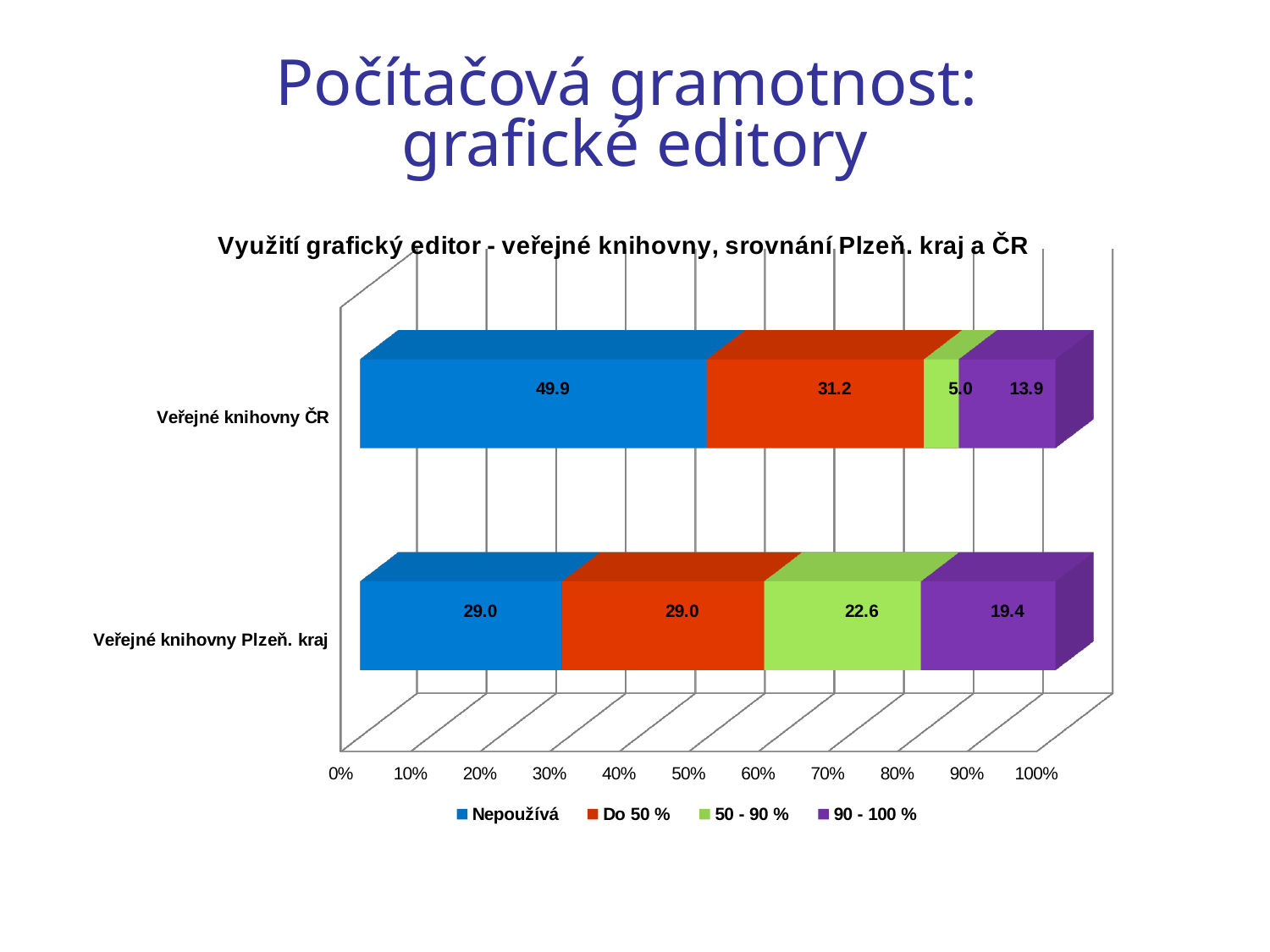
What is the difference between the "90 - 100 %" values for Veřejné knihovny Plzeň. kraj and Veřejné knihovny ČR? 5.5 How many series does the legend list? 4 What is the value of the "50 - 90 %" segment for Veřejné knihovny Plzeň. kraj? 22.6 What is the value of the "90 - 100 %" segment for Veřejné knihovny ČR? 13.9 Which segment is the smallest in the Veřejné knihovny ČR bar? 50 - 90 % Which category has the higher value for the "50 - 90 %" series? Veřejné knihovny Plzeň. kraj What is the value of the "Nepoužívá" segment for Veřejné knihovny ČR? 49.9 How many categories are shown on the chart? 2 What is the difference between the "Nepoužívá" values for Veřejné knihovny ČR and Veřejné knihovny Plzeň. kraj? 20.9 Which category has the higher value for the "Nepoužívá" series? Veřejné knihovny ČR What type of chart is shown on the slide? Stacked bar chart What is the value of the "Do 50 %" segment for Veřejné knihovny Plzeň. kraj? 29.0